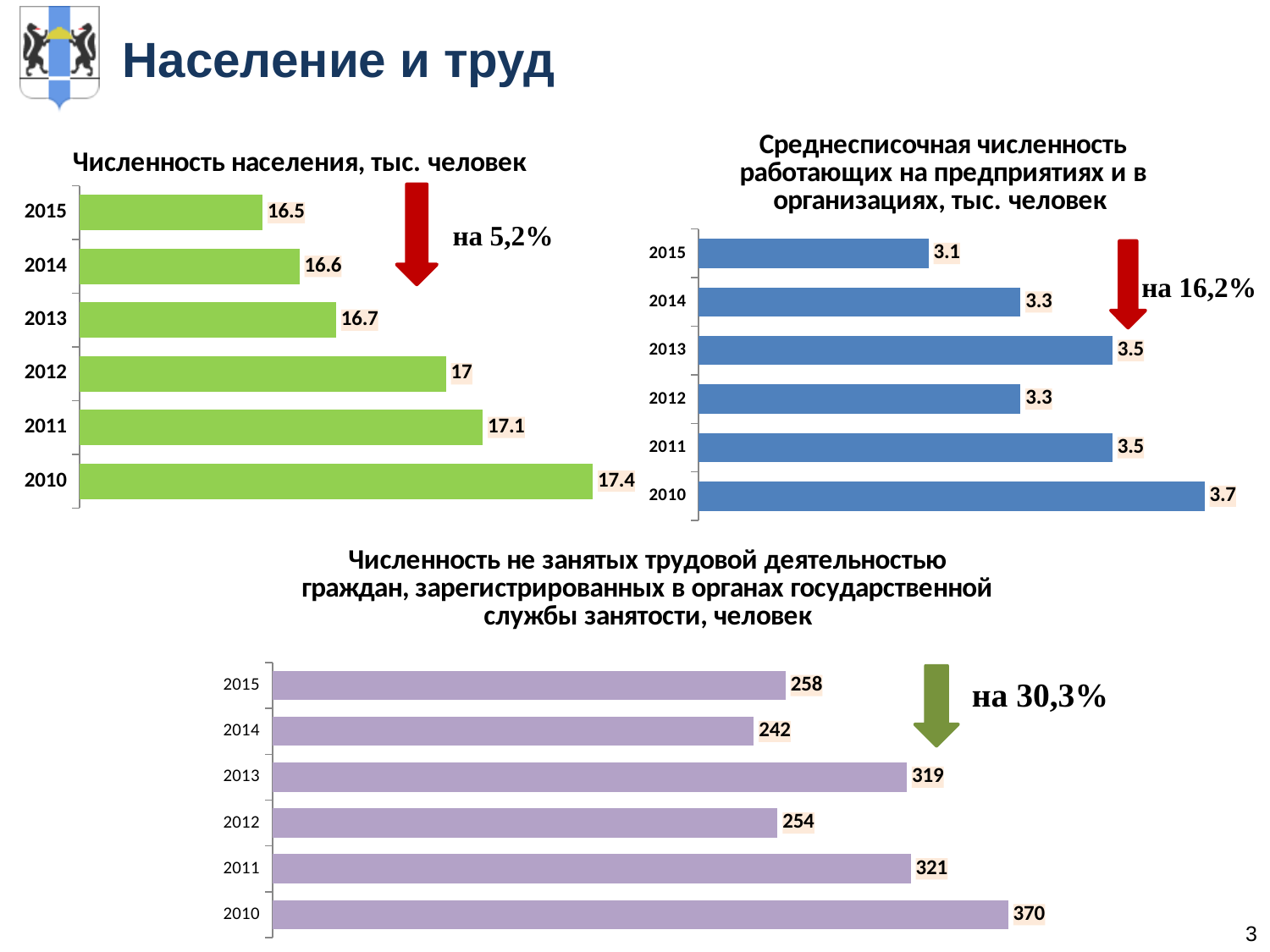
In the chart 'Численность не занятых трудовой деятельностью граждан, зарегистрированных в органах государственной службы занятости, человек', which year has the highest value? 2010 What kind of chart is the bottom chart on the slide? bar chart In the chart 'Численность населения, тыс. человек', which year has the highest value? 2010 In the chart 'Численность не занятых трудовой деятельностью граждан, зарегистрированных в органах государственной службы занятости, человек', which is larger, the value for 2013 or the value for 2014? 2013 In the chart 'Численность не занятых трудовой деятельностью граждан, зарегистрированных в органах государственной службы занятости, человек', what is the value for 2012? 254 In the chart 'Численность населения, тыс. человек', what is the value for 2013? 16.7 In the chart 'Среднесписочная численность работающих на предприятиях и в организациях, тыс. человек', what is the value for 2014? 3.3 In the chart 'Среднесписочная численность работающих на предприятиях и в организациях, тыс. человек', how many years are shown? 6 In the chart 'Численность не занятых трудовой деятельностью граждан, зарегистрированных в органах государственной службы занятости, человек', what is the difference between the values for 2010 and 2015? 112 In the chart 'Численность населения, тыс. человек', do the values rise or fall from 2010 to 2015? fall In the chart 'Численность населения, тыс. человек', what is the difference between the values for 2010 and 2015? 0.9 In the chart 'Среднесписочная численность работающих на предприятиях и в организациях, тыс. человек', which year has the lowest value? 2015